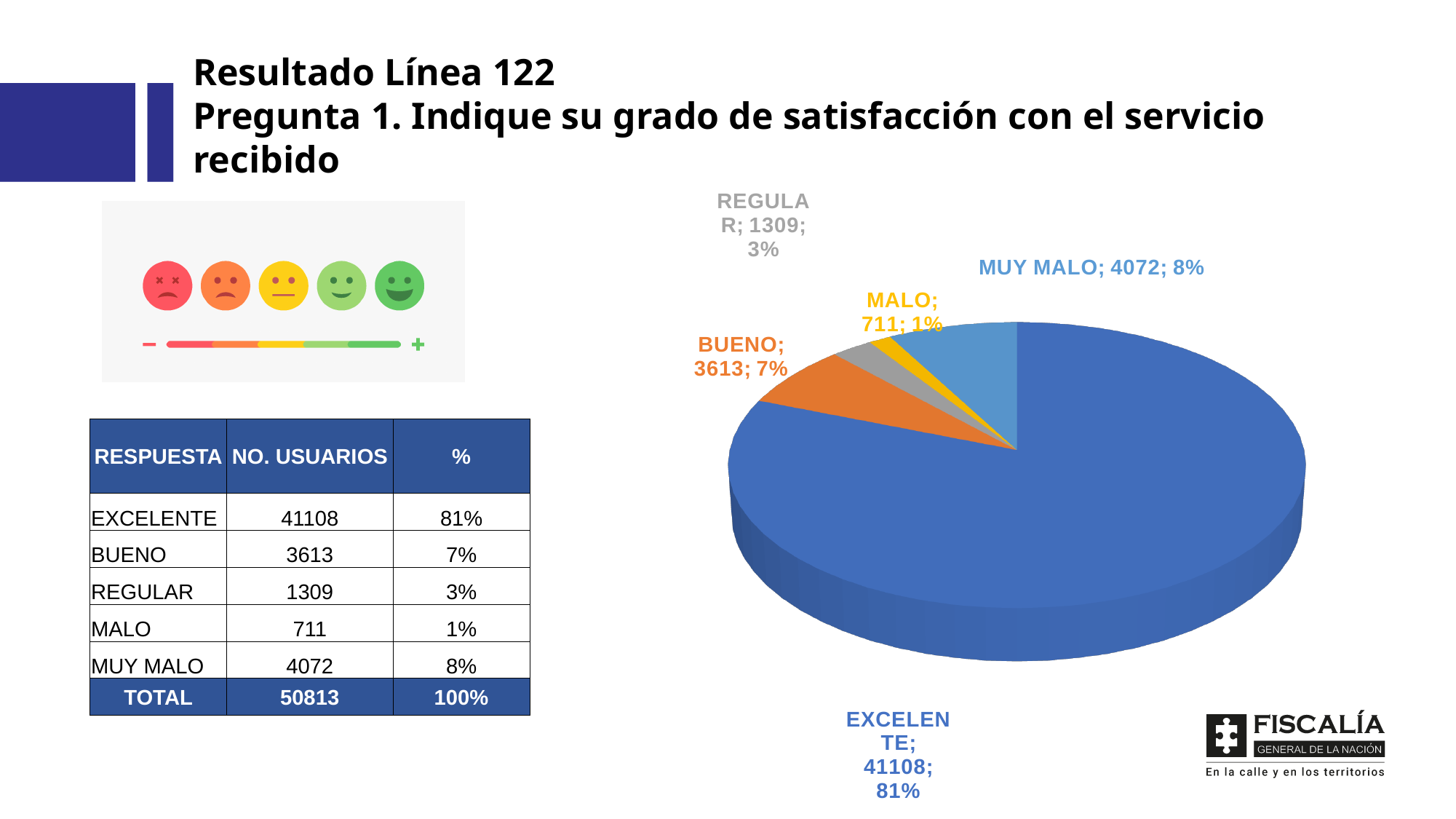
What is the number of users for EXCELENTE in the pie chart? 41108 What is the total of all the values shown in the pie chart? 50813 Which is larger in the pie chart, the value for REGULAR or the value for MALO? REGULAR What is the value shown for REGULAR in the pie chart? 1309 Which category has the smallest slice in the pie chart? MALO What colour is the EXCELENTE slice in the pie chart? Blue What percentage share does the BUENO slice represent? 7% What percentage share does the MUY MALO slice represent? 8% What kind of chart is shown on the slide? Pie chart Which category has the largest slice in the pie chart? EXCELENTE What is the difference between the MUY MALO and BUENO values in the pie chart? 459 How many slices does the pie chart have? 5